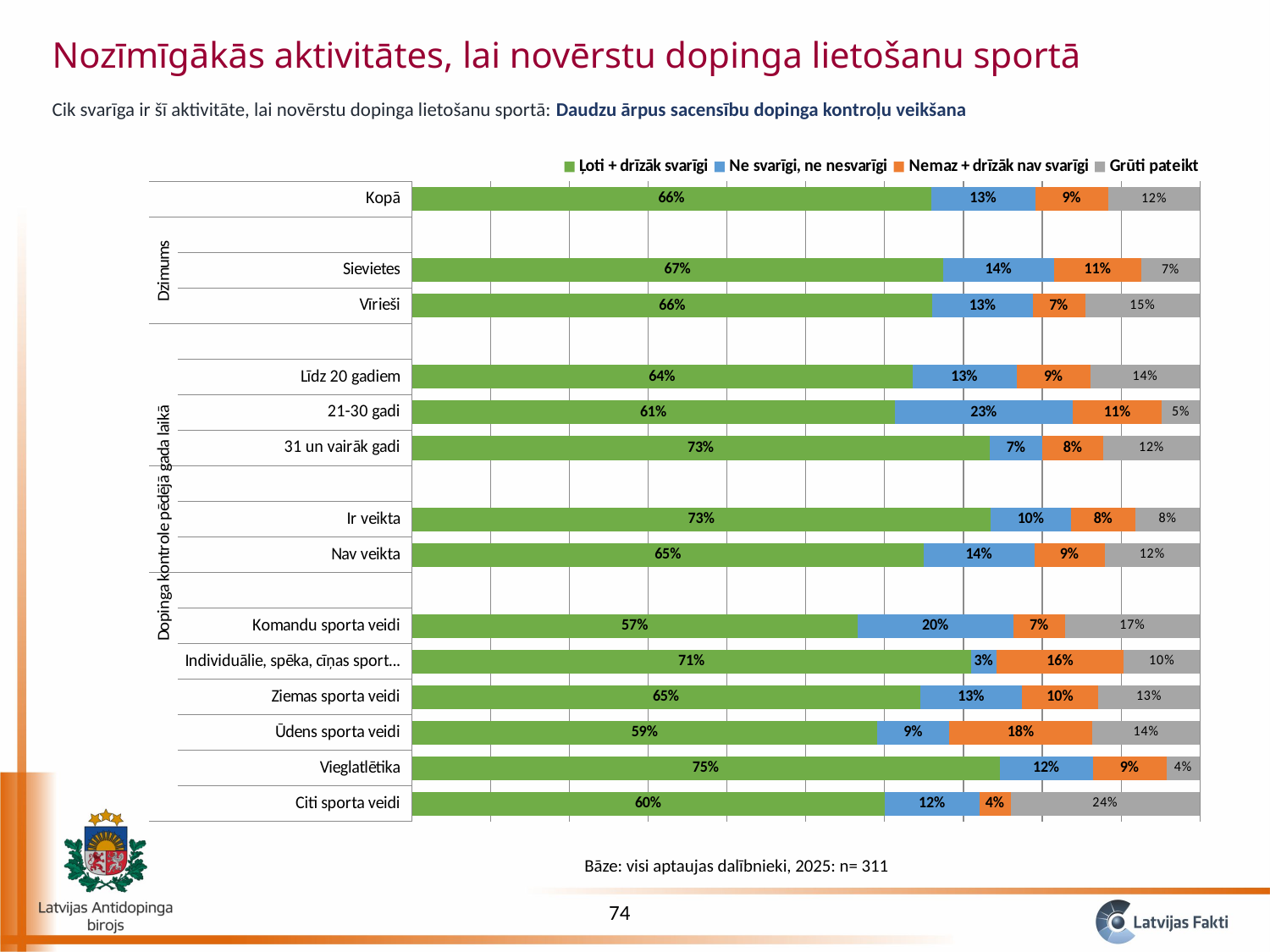
Which category has the highest value for "Nemaz + drīzāk nav svarīgi"? Ūdens sporta veidi What kind of chart is shown on the slide? Stacked bar chart What is the value of "Grūti pateikt" for Citi sporta veidi? 24% Which category has the lowest value for "Ļoti + drīzāk svarīgi"? Komandu sporta veidi What is the value of "Ļoti + drīzāk svarīgi" for Kopā? 66% Which series is shown in green in the chart? Ļoti + drīzāk svarīgi How many series does the legend list? 4 What is the difference between the "Ļoti + drīzāk svarīgi" values for Ir veikta and Nav veikta? 8 percentage points What is the value of "Ne svarīgi, ne nesvarīgi" for 21-30 gadi? 23% Which has a larger "Grūti pateikt" value, Sievietes or Vīrieši? Vīrieši How many categories (bars) are plotted in the chart? 14 Which category has the highest value for "Ļoti + drīzāk svarīgi"? Vieglatlētika